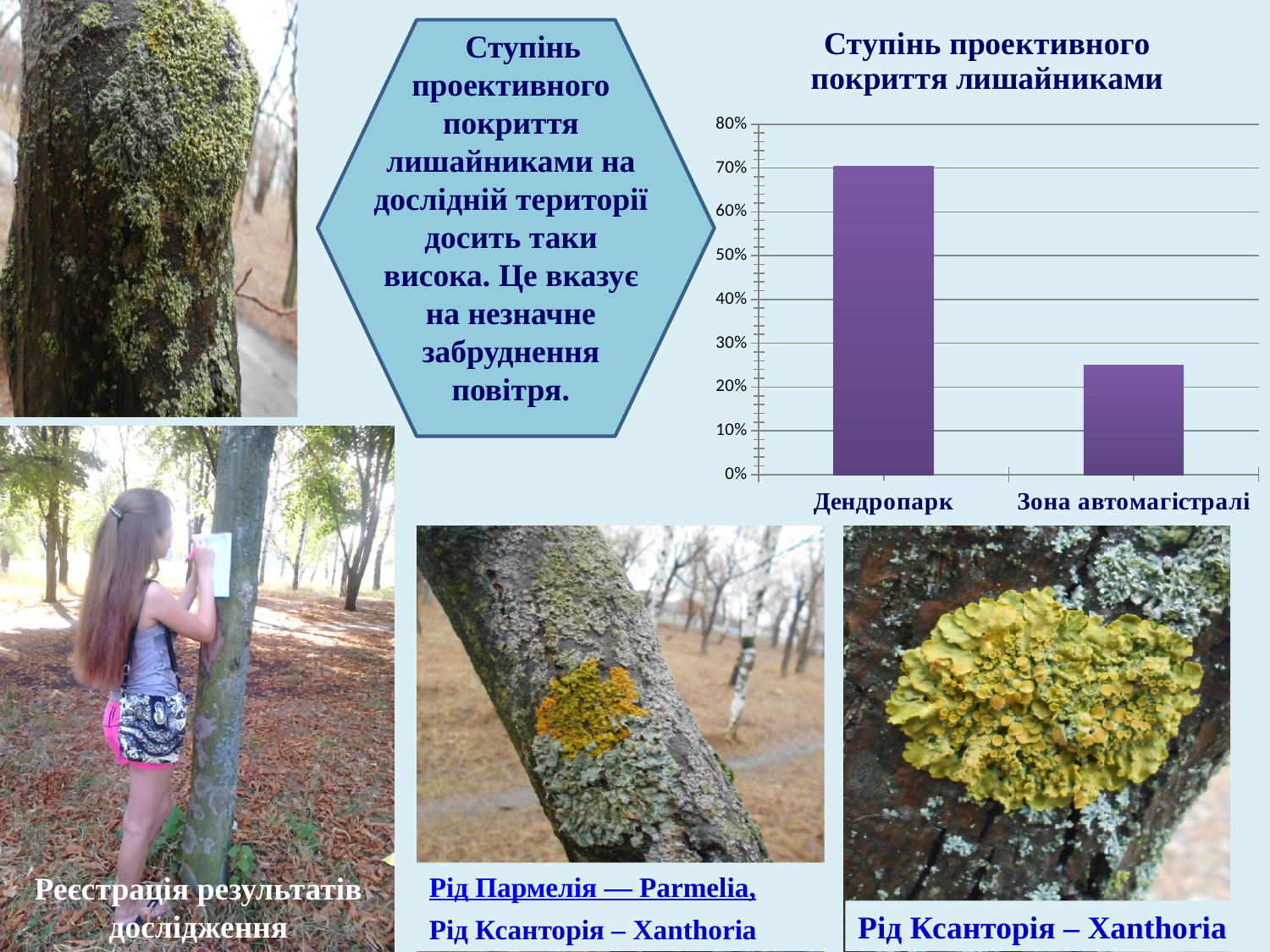
Is the value for Дендропарк greater or less than 60%? greater Is the value for Дендропарк greater or less than 80%? less What kind of chart is shown on the slide? bar chart Is the value for Зона автомагістралі greater or less than 20%? greater What is the title of the chart? Ступінь проективного покриття лишайниками Which category has the lowest value in the chart? Зона автомагістралі How many categories are shown on the x axis of the chart? 2 Do the values fall or rise from Дендропарк to Зона автомагістралі along the x axis? fall Which is larger, the value for Дендропарк or the value for Зона автомагістралі? Дендропарк Which category has the highest value in the chart? Дендропарк What is the highest value shown on the y axis of the chart? 80%